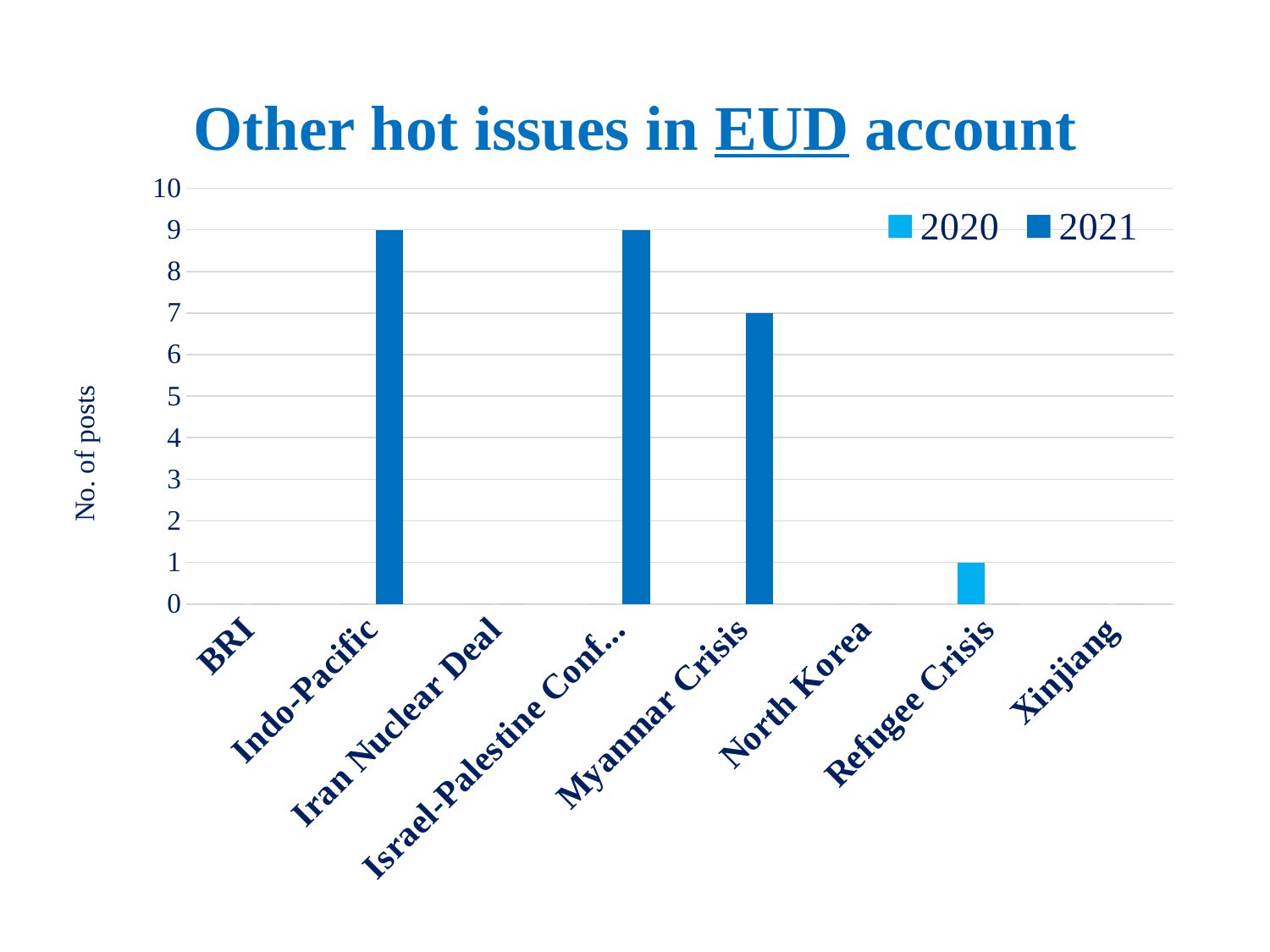
What is the 2021 value for Myanmar Crisis? 7 What is the 2021 value for Indo-Pacific? 9 Is the 2021 value for Myanmar Crisis greater or less than 5? greater Which category is the only one with a 2020 bar? Refugee Crisis How many series does the legend list? 2 What is the 2020 value for Refugee Crisis? 1 What kind of chart is shown on the slide? bar chart What is the difference between the 2021 values for Indo-Pacific and Myanmar Crisis? 2 Which is larger: the 2021 value for Myanmar Crisis or the 2020 value for Refugee Crisis? Myanmar Crisis (2021) What is the title of the y axis? No. of posts Which category has the lowest non-zero bar in the chart? Refugee Crisis How many categories are shown on the x axis? 8